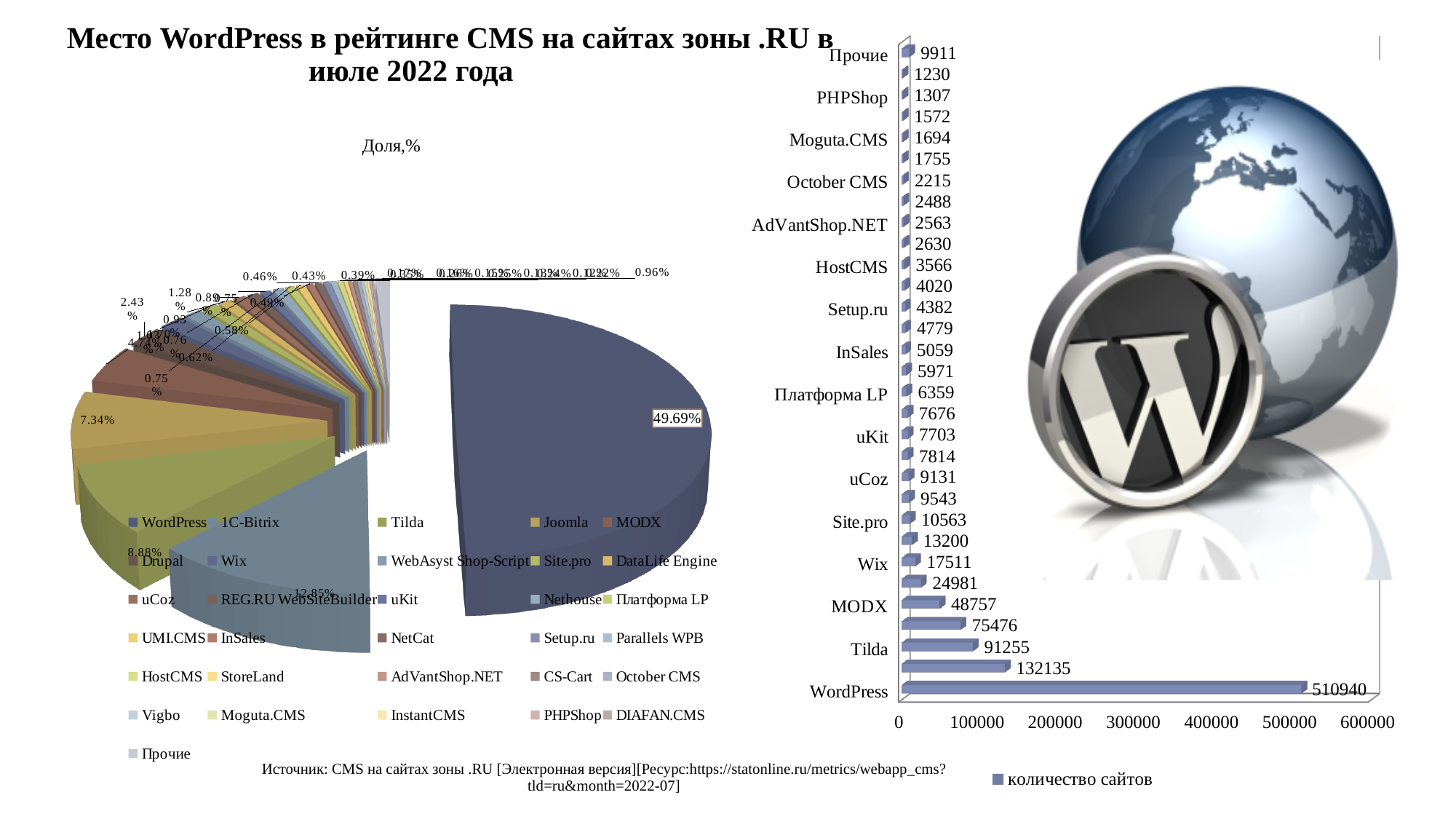
In the bar chart on the right, what is the value for Site.pro? 10563 In the pie chart titled 'Доля,%', what share does WordPress have? 49.69% In the bar chart on the right, what is the difference between the values for WordPress and Tilda? 419685 In the bar chart on the right, which category has the highest value? WordPress In the bar chart on the right, what is the value for Wix? 17511 In the bar chart on the right, what is the value for WordPress? 510940 In the bar chart on the right, what is the value for MODX? 48757 What kind of chart is the chart on the right of the slide? bar chart In the bar chart on the right, is the value for WordPress greater or less than 500000? greater What is the legend entry of the bar chart on the right? количество сайтов In the bar chart on the right, what is the value for Tilda? 91255 In the bar chart on the right, which is larger, the value for uCoz or the value for uKit? uCoz